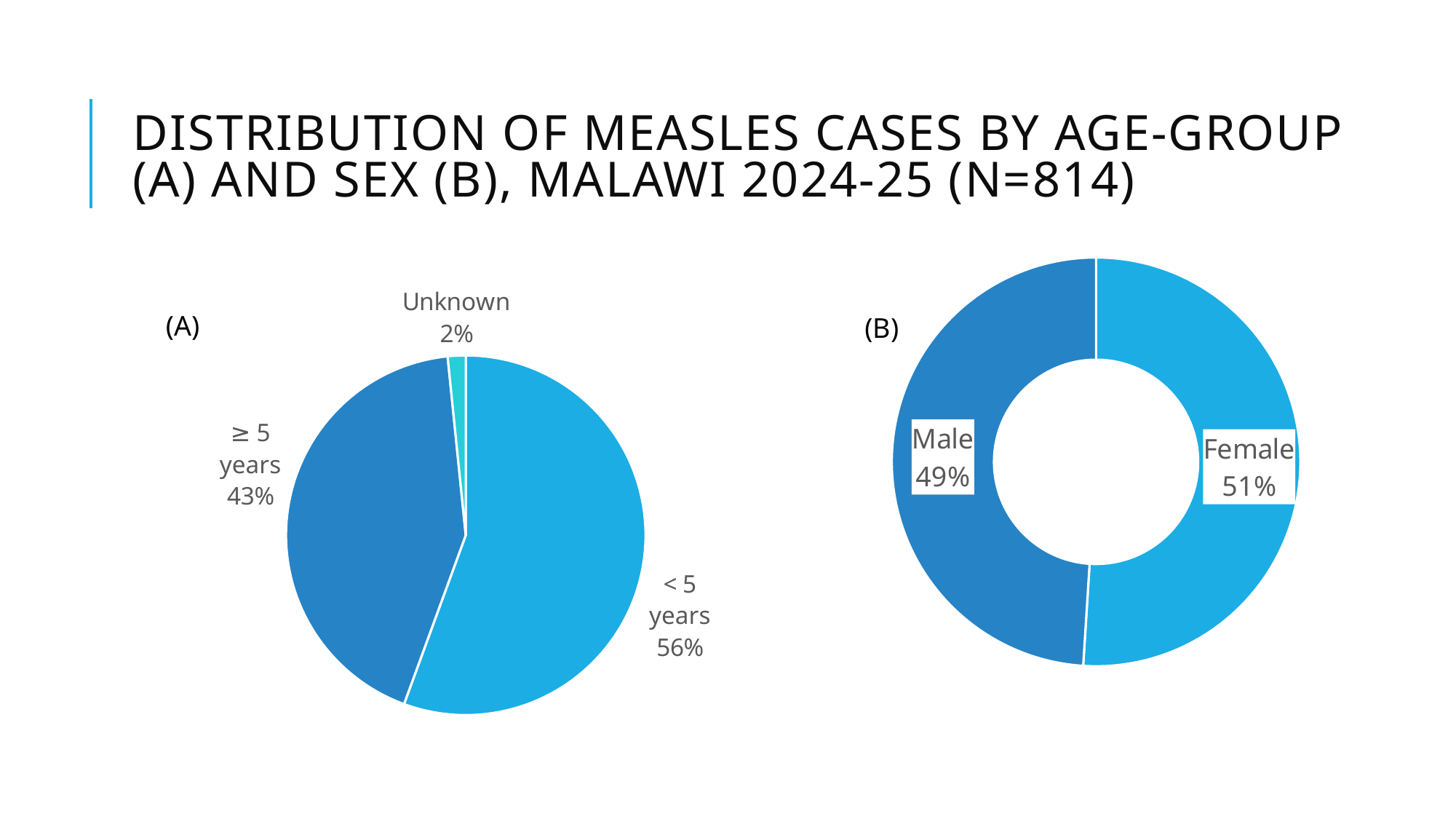
In chart (B), the sex chart, what is the difference in percentage points between the Female and Male shares? 2 percentage points In chart (A), the age-group pie chart, which age group has the largest share of cases? < 5 years In chart (A), the age-group pie chart, what share of cases has an Unknown age? 2% In chart (B), the sex chart, what share of measles cases is Male? 49% What type of chart is chart (A), the age-group chart? Pie chart In chart (B), the sex chart, what share of measles cases is Female? 51% In chart (A), the age-group pie chart, which category has the smallest share of cases? Unknown In chart (A), the age-group pie chart, how many categories are shown? 3 In chart (B), the sex chart, which sex has the larger share of cases, Male or Female? Female In chart (A), the age-group pie chart, what is the difference in percentage points between the < 5 years and ≥ 5 years shares? 13 percentage points